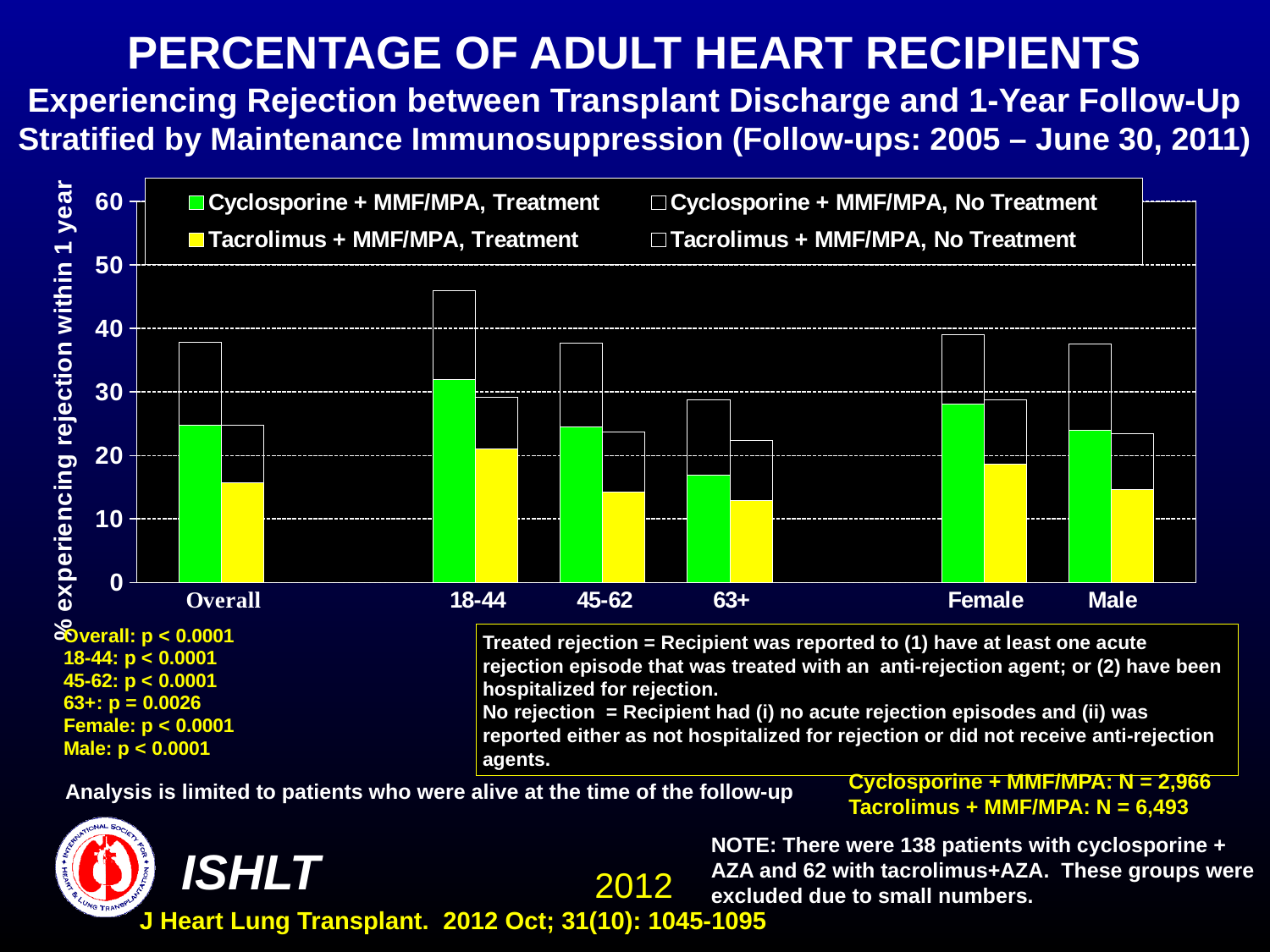
Is the value for Cyclosporine + MMF/MPA, Treatment in the Overall group greater or less than 20? greater What kind of chart is shown on the slide? bar chart Is the value for Tacrolimus + MMF/MPA, Treatment in the 63+ group greater or less than 20? less Among the age groups (18-44, 45-62, 63+), which has the highest value for Cyclosporine + MMF/MPA, Treatment? 18-44 In the 18-44 group, which is larger: Cyclosporine + MMF/MPA, Treatment or Tacrolimus + MMF/MPA, Treatment? Cyclosporine + MMF/MPA, Treatment Is the top of the full stacked Cyclosporine + MMF/MPA bar for the 18-44 group greater or less than 40? greater Which is larger for Cyclosporine + MMF/MPA, Treatment: Female or Male? Female What colour represents Tacrolimus + MMF/MPA, Treatment in the chart? yellow How many categories are shown along the x axis of the chart? 6 Among all categories, which has the lowest value for Cyclosporine + MMF/MPA, Treatment? 63+ How many series does the chart's legend list? 4